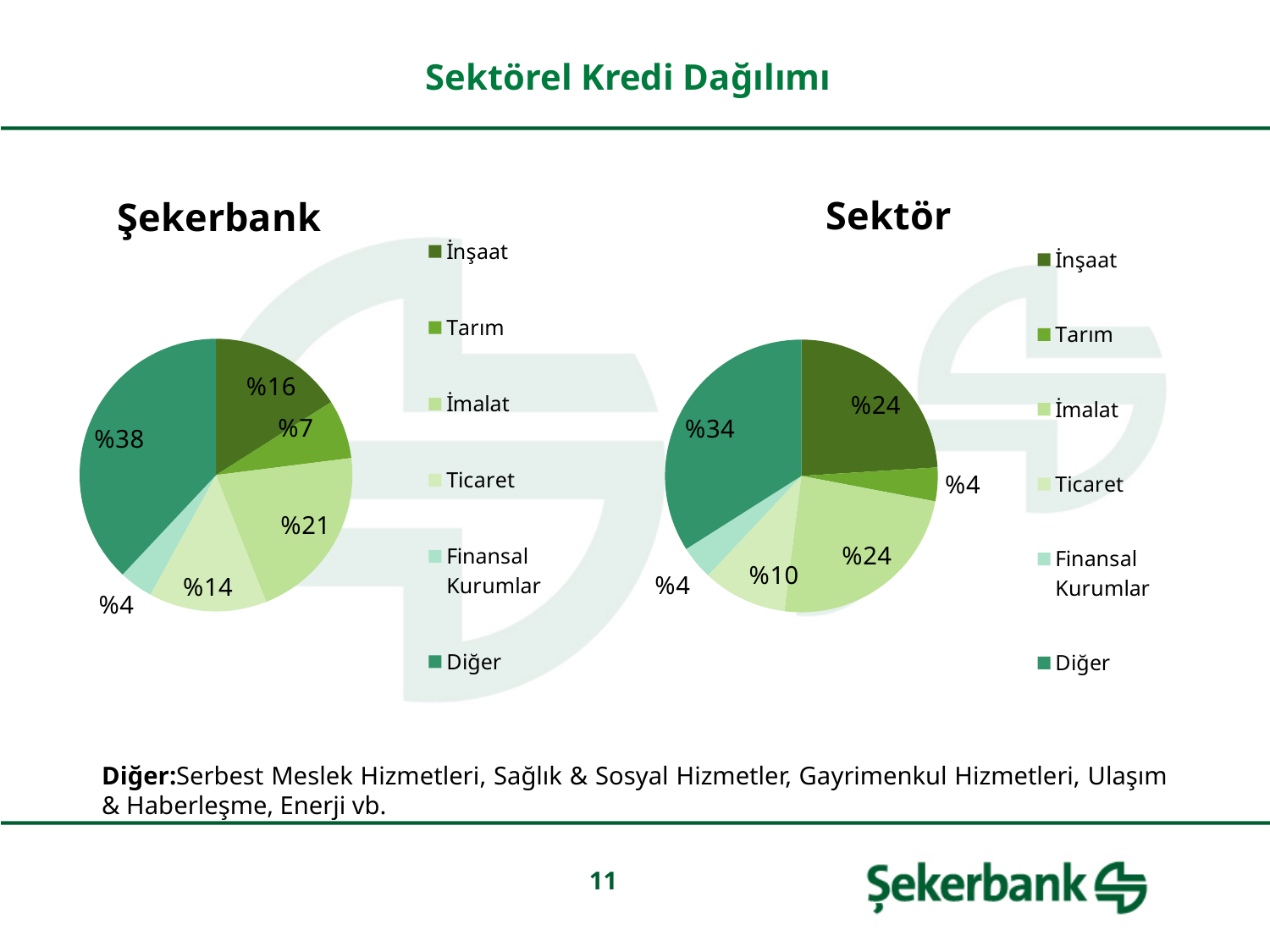
In the Şekerbank pie chart, what is the value for Diğer? %38 In the Sektör pie chart, which category has the largest share? Diğer How many categories does the Şekerbank pie chart show? 6 In the Şekerbank pie chart, what is the value for İmalat? %21 What type of chart is used for the Sektör data? Pie chart What is the title of the slide containing the two pie charts? Sektörel Kredi Dağılımı In the Şekerbank pie chart, which category has the smallest share? Finansal Kurumlar In the Sektör pie chart, what is the value for Ticaret? %10 In the Şekerbank pie chart, which category has the largest share? Diğer In the Sektör pie chart, what is the value for İnşaat? %24 Which is larger: Tarım in the Şekerbank chart or Tarım in the Sektör chart? Şekerbank What is the difference between the İnşaat values in the Sektör chart and the Şekerbank chart? %8